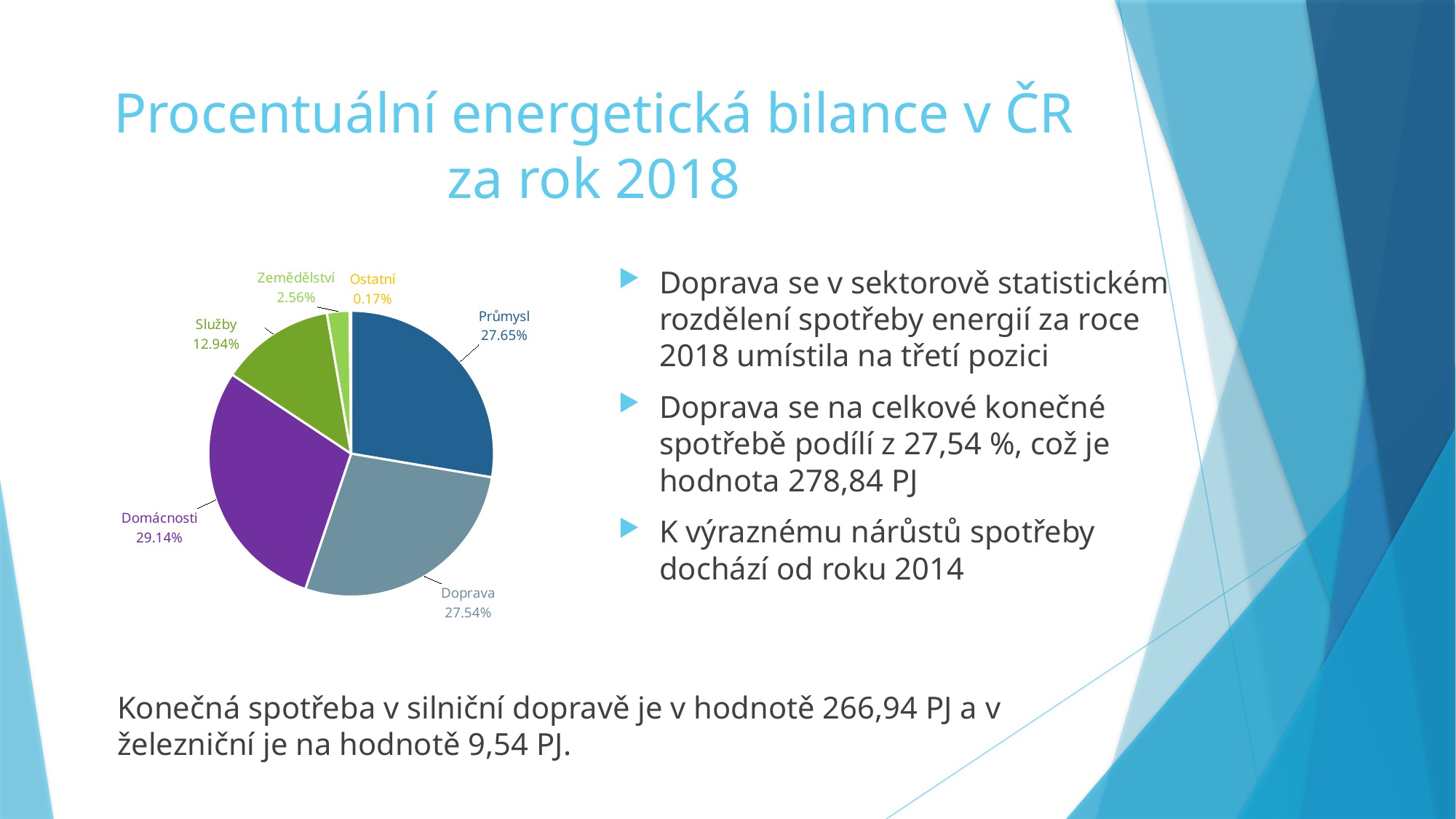
What colour is the Domácnosti slice? Purple Which has the larger share, Průmysl or Doprava? Průmysl What type of chart is shown on the slide? Pie chart What is the value shown for Průmysl? 27.65% Which category has the largest share of the pie? Domácnosti What percentage is shown for Služby? 12.94% What is the difference in percentage points between Domácnosti and Průmysl? 1.49 What is the difference in percentage points between Služby and Zemědělství? 10.38 What share of the pie does Doprava hold? 27.54% What is the value for Zemědělství? 2.56% Which category has the smallest share of the pie? Ostatní How many categories are shown in the pie chart? 6